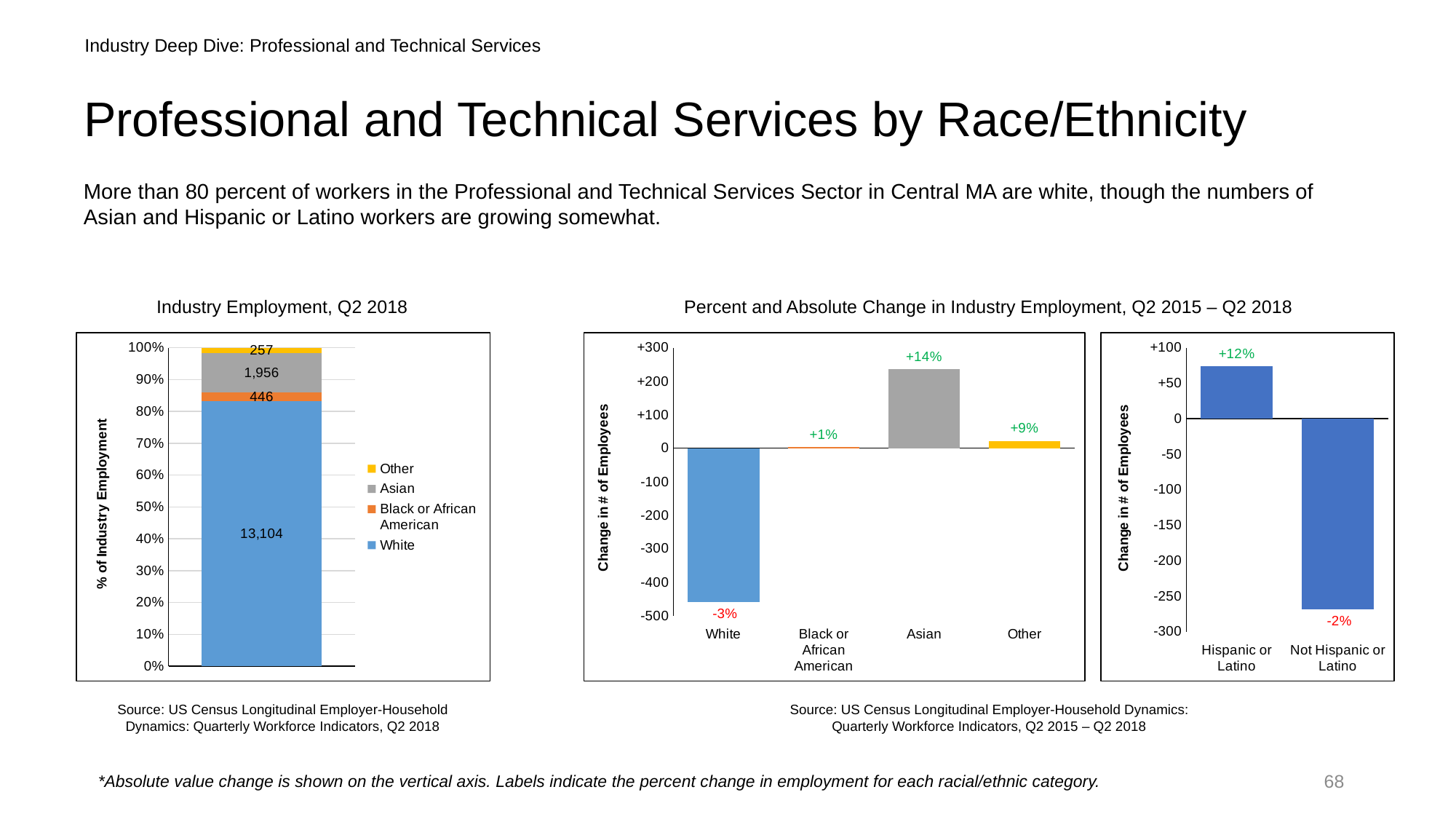
In the rightmost chart (change in employment for Hispanic or Latino vs Not Hispanic or Latino), what percent change is labelled for Hispanic or Latino? +12% In the rightmost chart (change in employment for Hispanic or Latino vs Not Hispanic or Latino), is the change in number of employees for Not Hispanic or Latino greater or less than -250? less In the 'Industry Employment, Q2 2018' chart, what is the number of Asian employees? 1,956 In the 'Industry Employment, Q2 2018' chart, what is the total of all four labelled segments in the stacked bar? 15,763 What kind of chart is the 'Industry Employment, Q2 2018' chart? Stacked bar chart In the middle chart (Percent and Absolute Change in Industry Employment by race), how many racial categories are plotted? 4 In the middle chart (Percent and Absolute Change in Industry Employment by race), is the change in number of employees for White greater or less than -400? less In the 'Industry Employment, Q2 2018' chart, how many White employees are shown? 13,104 In the 'Industry Employment, Q2 2018' chart, how many series does the legend list? 4 In the middle chart (Percent and Absolute Change in Industry Employment by race), what percent change is labelled for White? -3% In the middle chart (Percent and Absolute Change in Industry Employment by race), what percent change is labelled for Asian? +14% In the middle chart (Percent and Absolute Change in Industry Employment by race), which category has the largest increase in number of employees? Asian